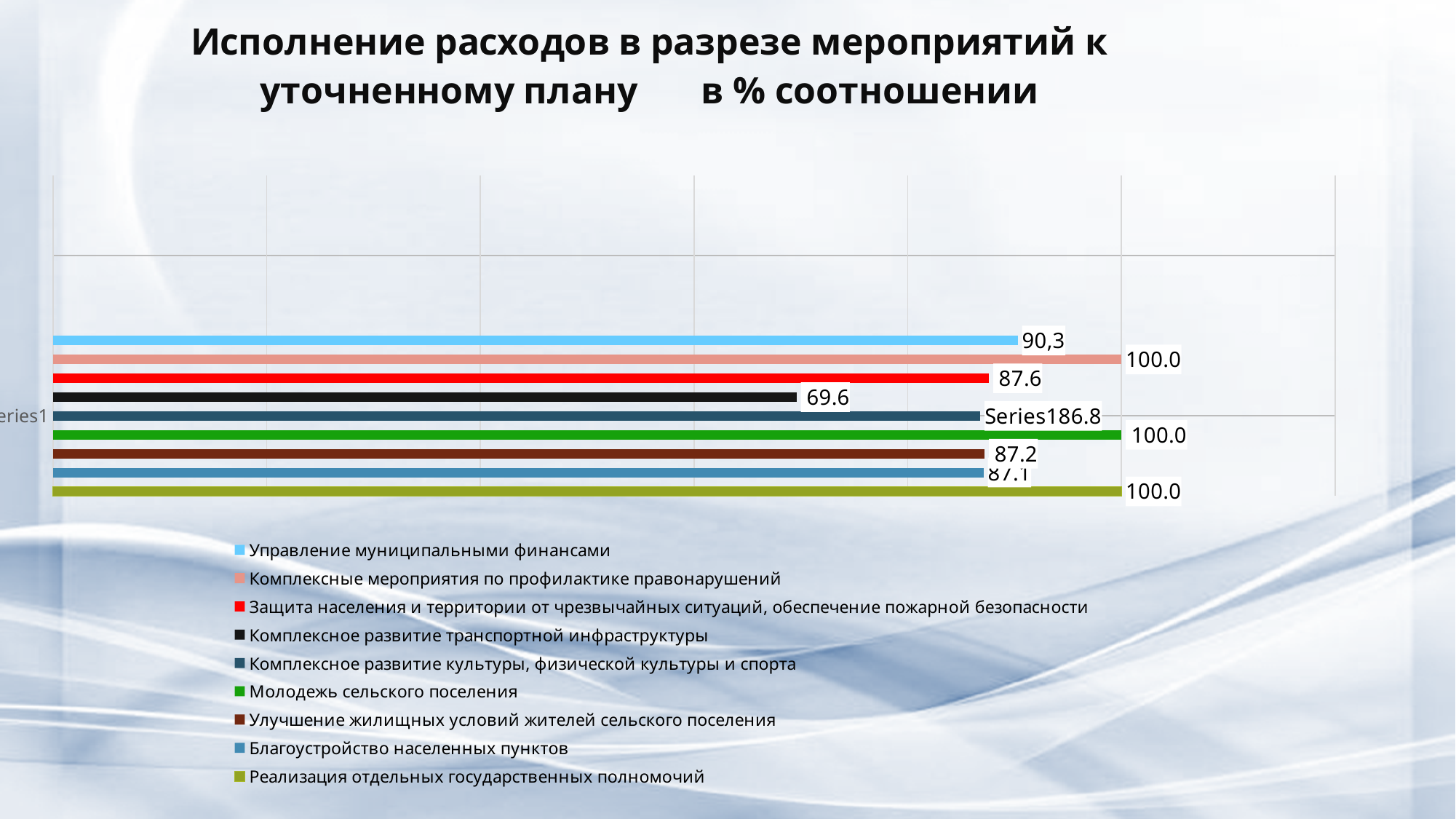
What is the difference between the values for Управление муниципальными финансами and Комплексное развитие транспортной инфраструктуры? 20.7 How many series does the legend list? 9 Which is larger: the value for Управление муниципальными финансами or the value for Защита населения и территории от чрезвычайных ситуаций, обеспечение пожарной безопасности? Управление муниципальными финансами What is the value for Управление муниципальными финансами? 90,3 What is the value for Комплексное развитие транспортной инфраструктуры? 69.6 How many series have a value of 100.0? 3 What is the value for Комплексное развитие культуры, физической культуры и спорта? 86.8 What is the value for Улучшение жилищных условий жителей сельского поселения? 87.2 What kind of chart is shown on the slide? bar chart What is the value for Молодежь сельского поселения? 100.0 What is the value for Защита населения и территории от чрезвычайных ситуаций, обеспечение пожарной безопасности? 87.6 Which series has the lowest value? Комплексное развитие транспортной инфраструктуры